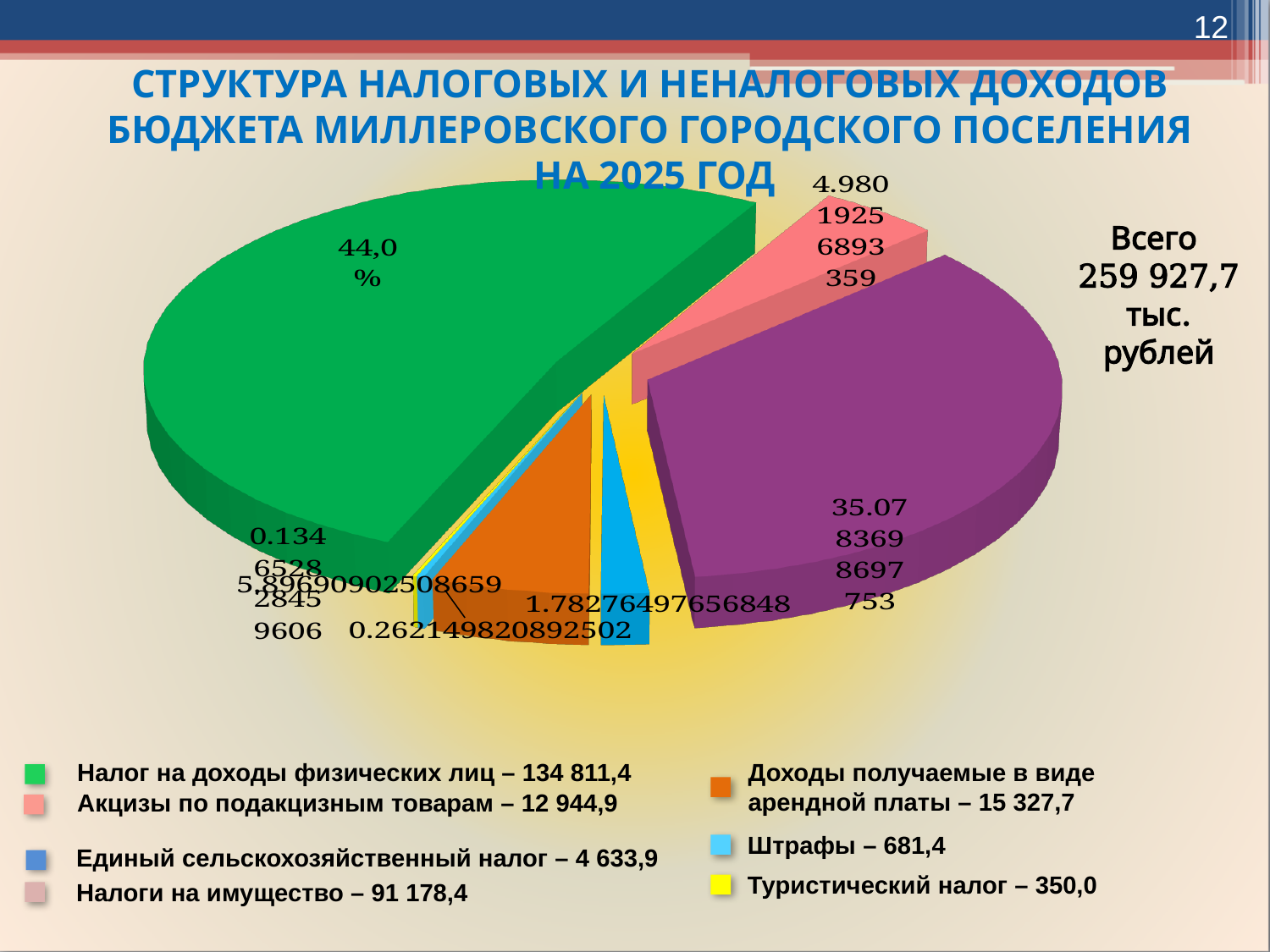
What is the value for Налоги на имущество according to the legend? 91 178,4 Which category has the smallest value? Туристический налог What is the value for Штрафы according to the legend? 681,4 Which is larger: Акцизы по подакцизным товарам or Доходы получаемые в виде арендной платы? Доходы получаемые в виде арендной платы How many categories does the legend of the pie chart list? 7 What is the value for Доходы получаемые в виде арендной платы according to the legend? 15 327,7 What is the value for Налог на доходы физических лиц according to the legend? 134 811,4 What share of the pie does the green slice (Налог на доходы физических лиц) represent? 44,0 % Which category has the largest value? Налог на доходы физических лиц What kind of chart is shown on the slide? pie chart What is the difference between Налог на доходы физических лиц and Налоги на имущество? 43 633,0 What total amount (Всего) is stated on the slide for the pie chart? 259 927,7 тыс. рублей